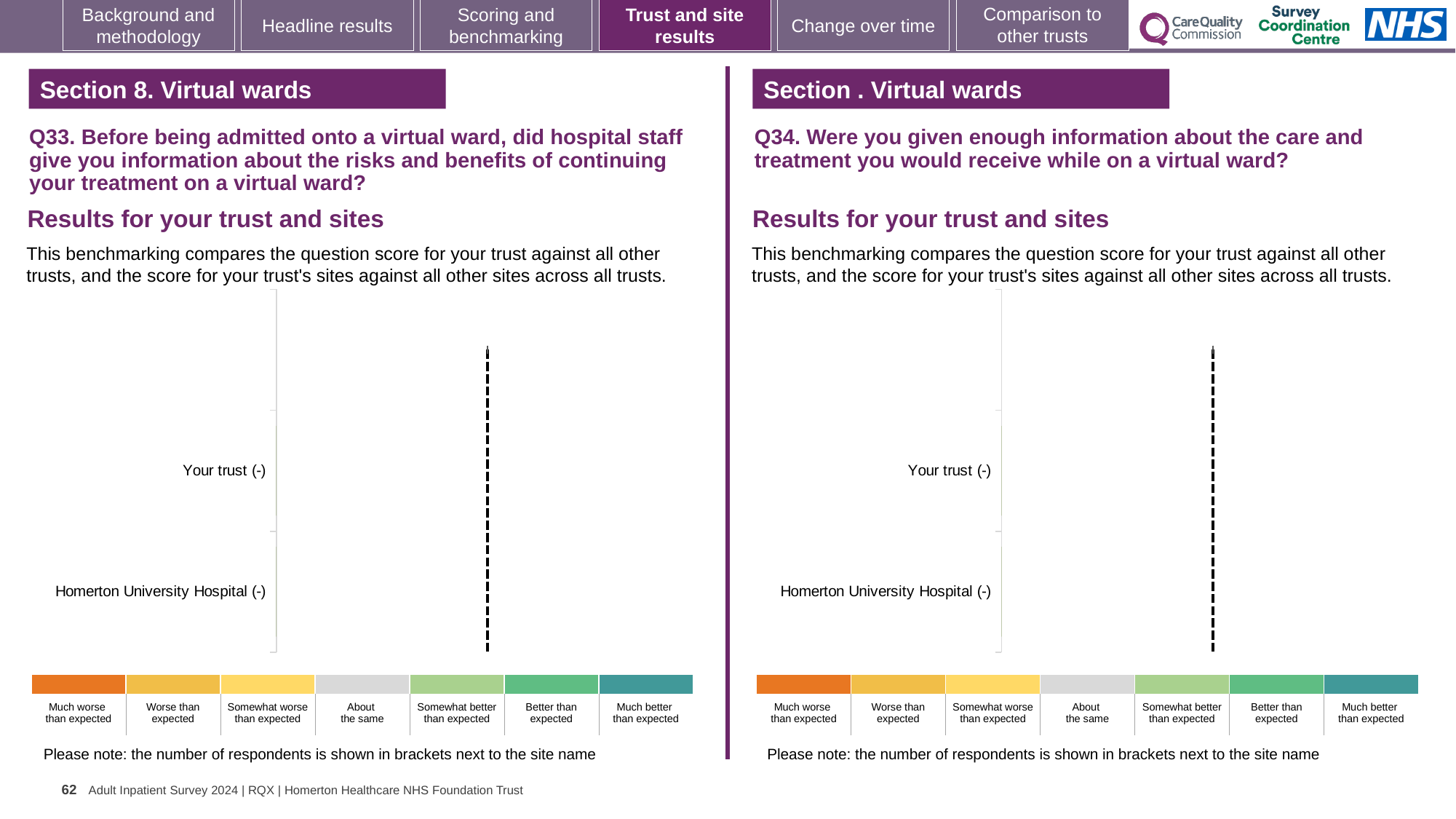
On the left chart (Q33), how many categories are listed on the vertical axis? 2 On the right chart (Q34), how many categories are listed on the vertical axis? 2 On the right chart (Q34), what is the label of the top category? Your trust (-) On the right chart (Q34), how many benchmark bands are shown in the colour key below the chart? 7 On the right chart (Q34), what is shown in brackets next to 'Homerton University Hospital'? - On the left chart (Q33), what is the label of the bottom category? Homerton University Hospital (-) On the left chart (Q33), what is shown in brackets next to 'Your trust'? -